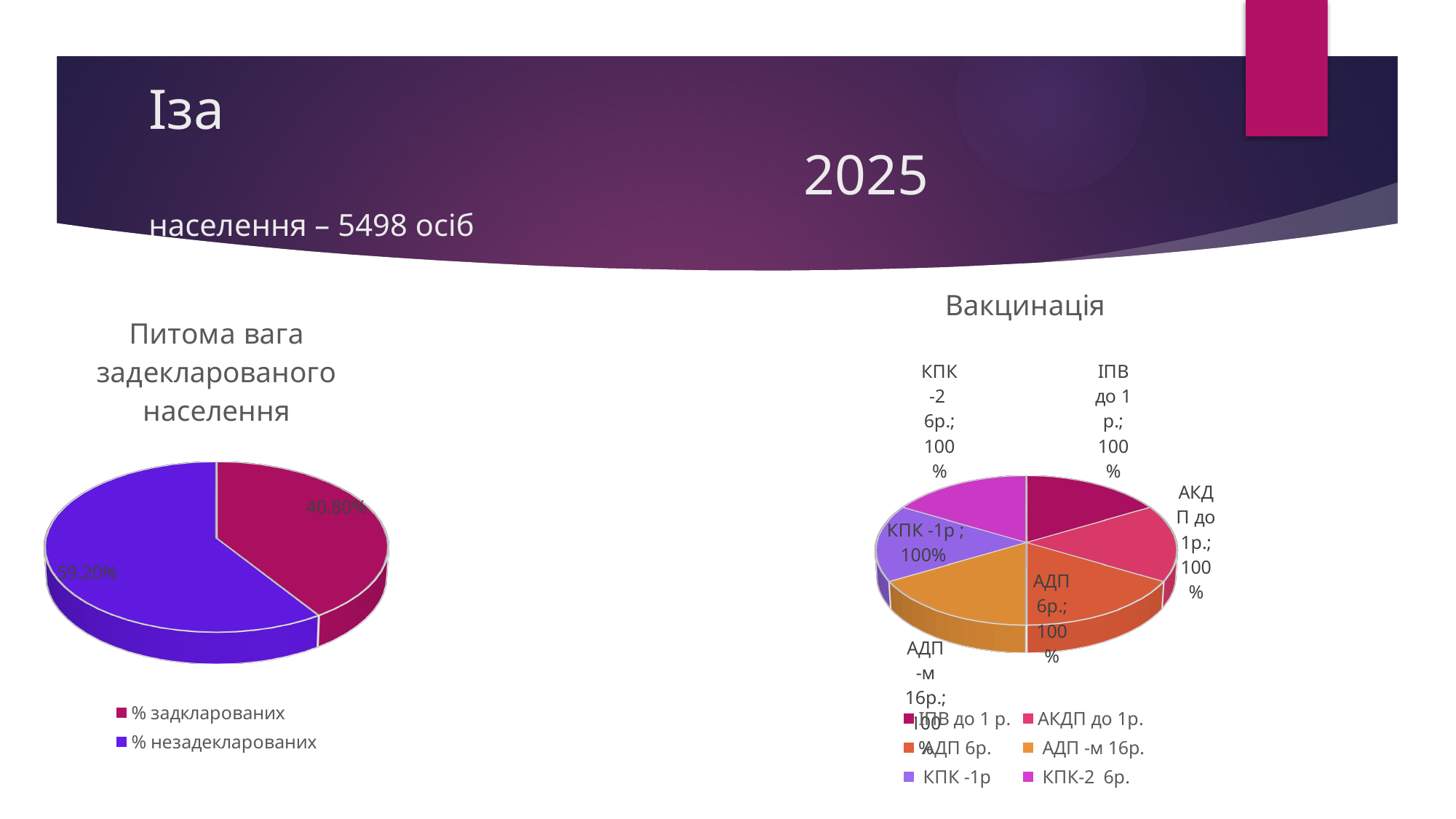
In the chart titled "Питома вага задекларованого населення", which category has the smaller share? % задкларованих In the chart titled "Вакцинація", what value is shown for "КПК -1р"? 100% In the chart titled "Питома вага задекларованого населення", is the value for "% задкларованих" larger or smaller than the value for "% незадекларованих"? smaller In the chart titled "Вакцинація", what value is shown for "АДП 6р."? 100% What kind of chart is the one titled "Питома вага задекларованого населення"? pie chart In the chart titled "Питома вага задекларованого населення", what is the value for "% задкларованих"? 40.80% In the chart titled "Питома вага задекларованого населення", what is the value for "% незадекларованих"? 59.20% What kind of chart is the one titled "Вакцинація"? pie chart How many categories does the legend of the chart titled "Питома вага задекларованого населення" list? 2 In the chart titled "Питома вага задекларованого населення", what is the difference between the "% незадекларованих" and "% задкларованих" values? 18.40% How many categories does the legend of the chart titled "Вакцинація" list? 6 In the chart titled "Питома вага задекларованого населення", which category has the larger share? % незадекларованих